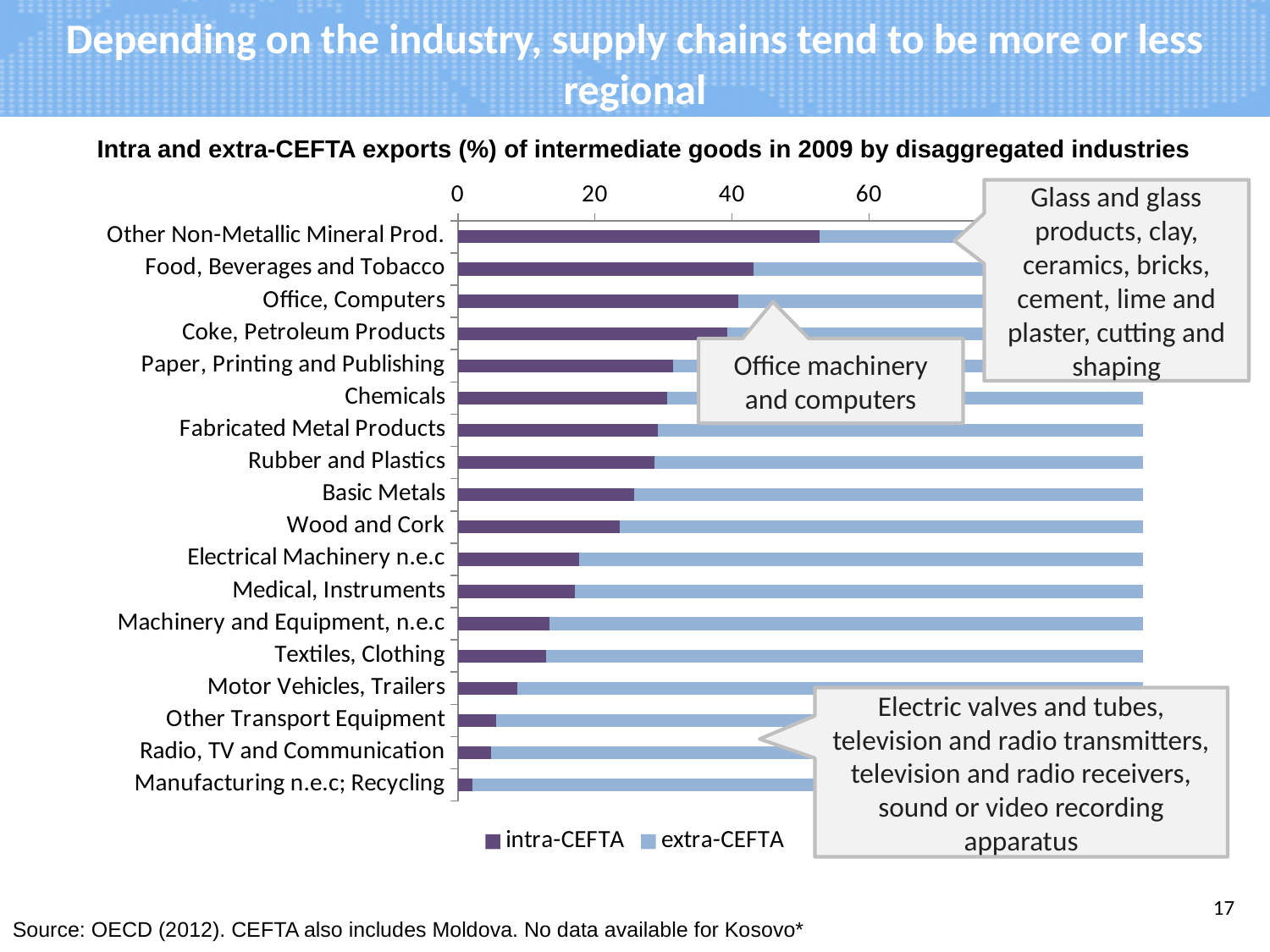
Which has the larger intra-CEFTA share, Textiles, Clothing or Motor Vehicles, Trailers? Textiles, Clothing How many industry categories are plotted on the chart? 18 Which industry has the lowest intra-CEFTA share? Manufacturing n.e.c; Recycling Which industry has the highest intra-CEFTA share? Other Non-Metallic Mineral Prod. Is the intra-CEFTA value for Chemicals greater or less than 40? less Is the intra-CEFTA value for Other Non-Metallic Mineral Prod. greater or less than 40? greater Is the intra-CEFTA value for Basic Metals greater or less than 20? greater What are the two series named in the chart's legend? intra-CEFTA and extra-CEFTA What kind of chart is shown on the slide? bar chart How many series does the chart's legend list? 2 Which has the larger intra-CEFTA share, Coke, Petroleum Products or Chemicals? Coke, Petroleum Products